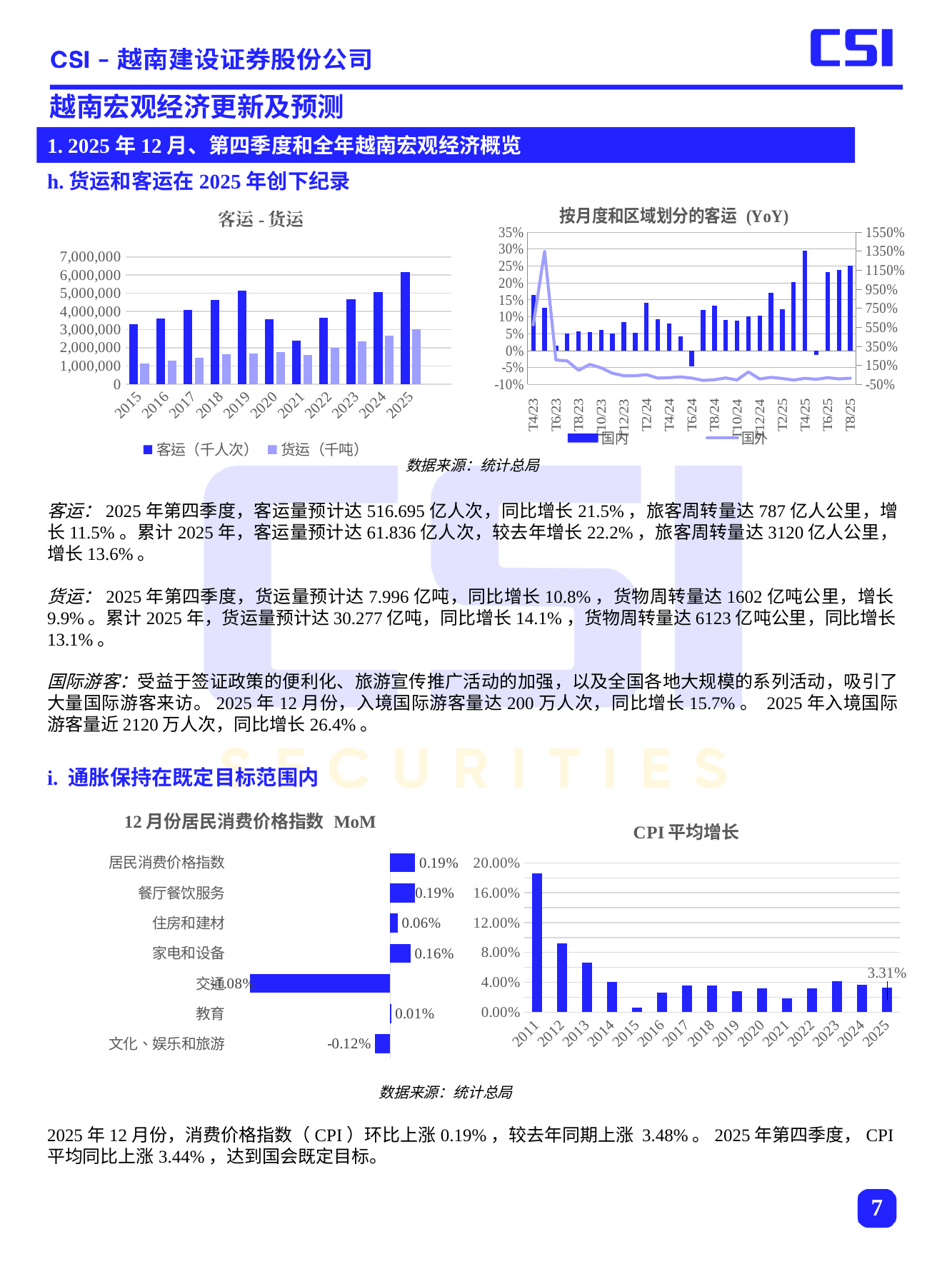
In the chart titled '12 月份居民消费价格指数 MoM', what is the value for 住房和建材? 0.06% In the chart titled 'CPI 平均增长', which year has the lowest value? 2015 In the chart titled '12 月份居民消费价格指数 MoM', what is the difference between the values for 家电和设备 and 住房和建材? 0.10% In the chart titled '12 月份居民消费价格指数 MoM', how many categories are shown? 7 In the chart titled 'CPI 平均增长', is the value for 2011 greater or less than 16.00%? greater In the chart titled '12 月份居民消费价格指数 MoM', what is the value for 文化、娱乐和旅游? -0.12% In the chart titled '12 月份居民消费价格指数 MoM', which category has the lowest value? 交通 In the chart titled '客运 - 货运', which year has the lowest value for 客运（千人次）? 2021 In the chart titled '按月度和区域划分的客运 (YoY)', which series is drawn as a line? 国外 In the chart titled '客运 - 货运', how many series does the legend list? 2 In the chart titled 'CPI 平均增长', which year has the highest value? 2011 In the chart titled 'CPI 平均增长', what is the value for 2025? 3.31%